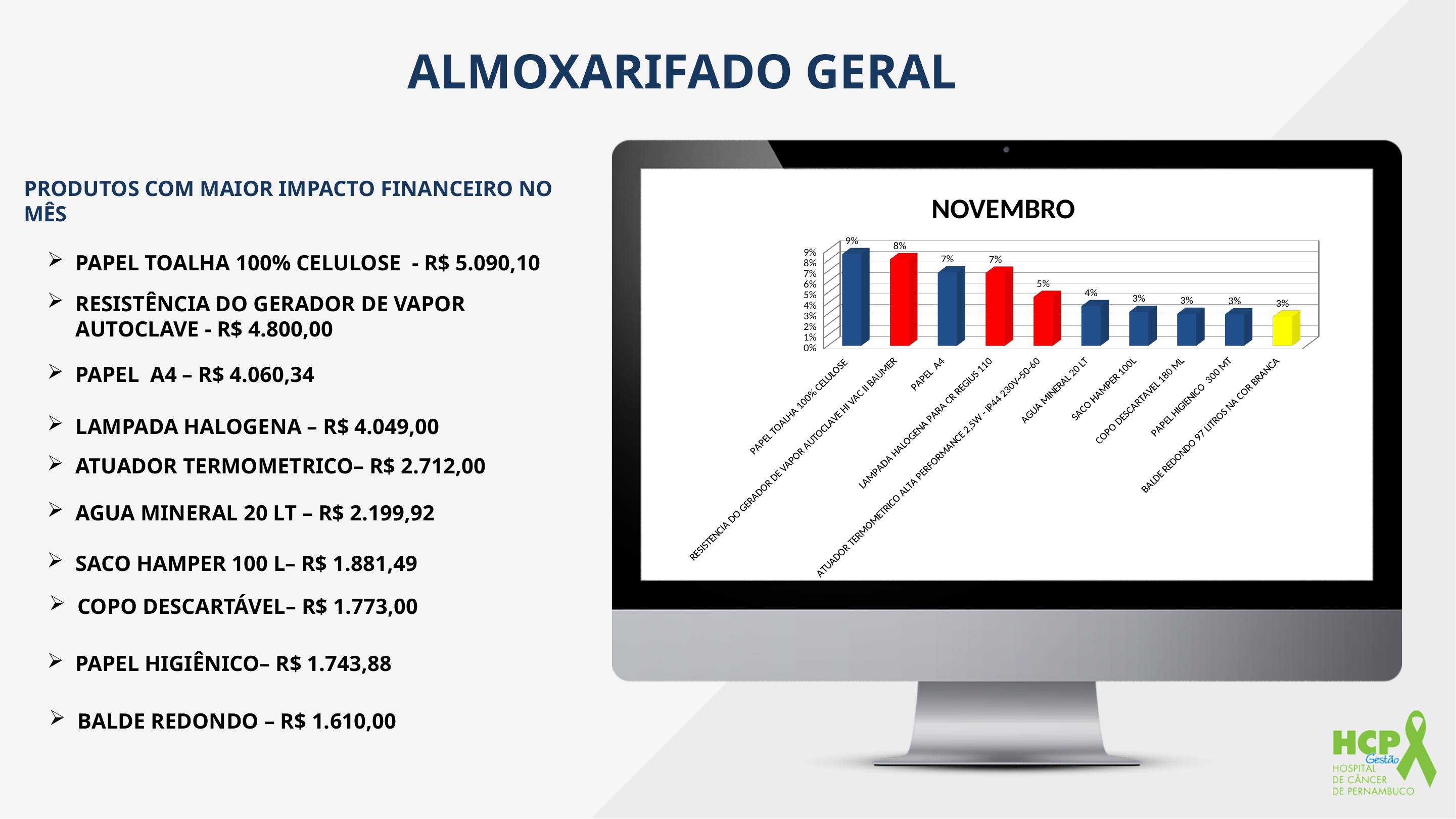
What colour is the bar for BALDE REDONDO 97 LITROS NA COR BRANCA? yellow What is the value for AGUA MINERAL 20 LT? 4% What is the title of the chart? NOVEMBRO What is the value for PAPEL A4? 7% How many categories (bars) does the chart show? 10 Do the values generally rise or fall from left to right along the x axis? fall What is the difference between the values for PAPEL TOALHA 100% CELULOSE and SACO HAMPER 100L? 6% What kind of chart is shown on the slide? bar chart What is the value for PAPEL TOALHA 100% CELULOSE? 9% What is the value for ATUADOR TERMOMETRICO ALTA PERFORMANCE 2,5W - IP44 230V~50-60? 5% Which category has the highest value? PAPEL TOALHA 100% CELULOSE Which is larger, the value for RESISTENCIA DO GERADOR DE VAPOR AUTOCLAVE HI VAC II BAUMER or the value for AGUA MINERAL 20 LT? RESISTENCIA DO GERADOR DE VAPOR AUTOCLAVE HI VAC II BAUMER